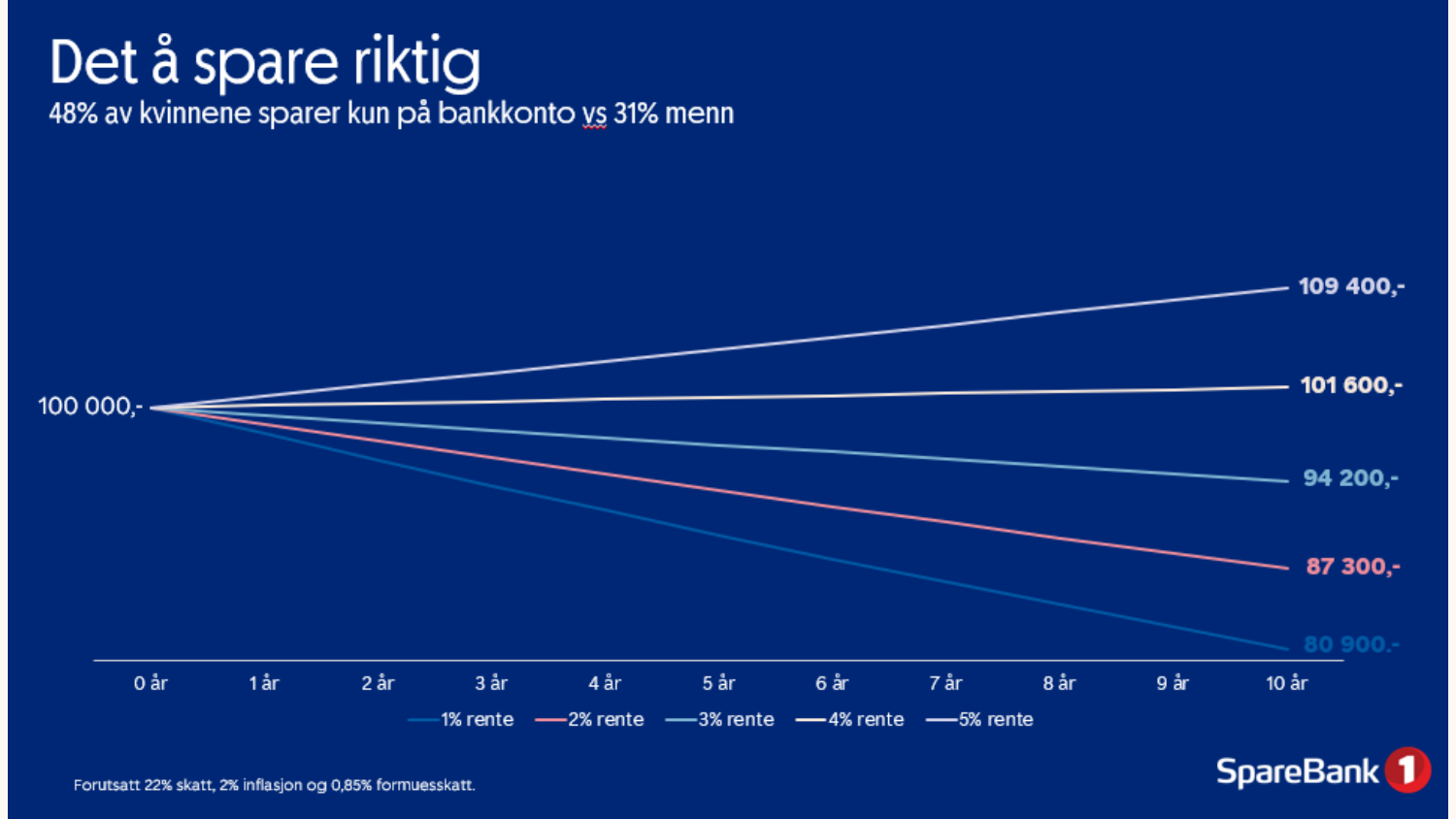
Which is larger at 10 år, the 3% rente line or the 2% rente line? 3% rente Which series has the lowest value at 10 år? 1% rente Does the 2% rente line rise or fall from 0 år to 10 år? fall What type of chart is shown on the slide? line chart What is the value of the 5% rente line at 10 år? 109 400,- How many series does the legend list? 5 What is the starting value of all lines at 0 år? 100 000,- What is the value of the 2% rente line at 10 år? 87 300,- What is the difference between the highest and lowest values at 10 år? 28 500,- What is the value of the 1% rente line at 10 år? 80 900,- How many year points are shown on the x axis? 11 Which series has the highest value at 10 år? 5% rente